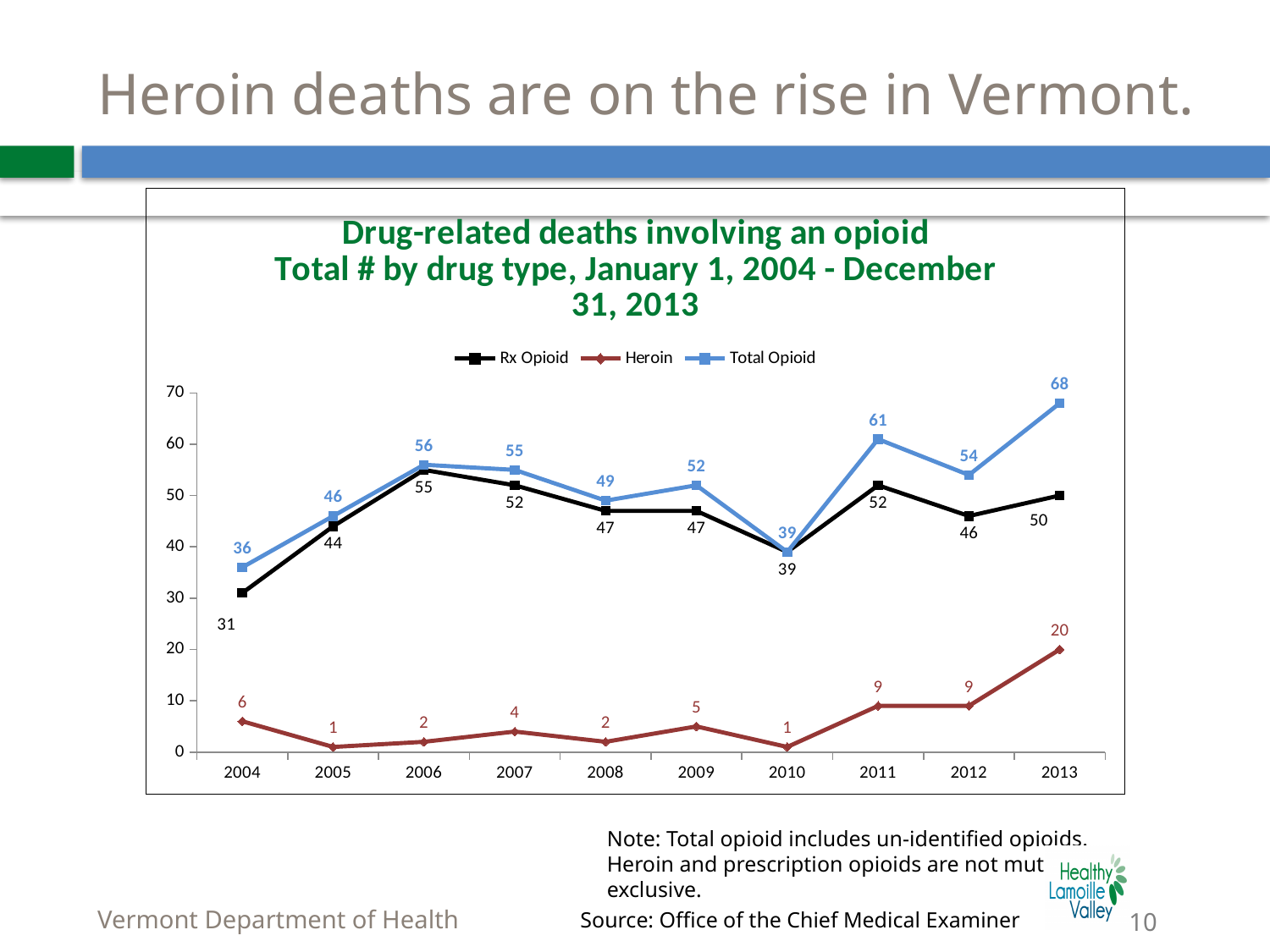
What kind of chart is shown on the slide? line chart Is the Total Opioid value for 2010 greater or less than 40? less How many series does the legend list? 3 How many years are shown on the x axis? 10 Does the Heroin series rise or fall from 2010 to 2013? rise In which year is the Rx Opioid series lowest? 2004 What is the difference between the Total Opioid and Rx Opioid values in 2011? 9 What is the Rx Opioid value for 2004? 31 What is the Heroin value for 2010? 1 What is the Total Opioid value for 2013? 68 In which year is the Total Opioid series highest? 2013 Which is larger, the Heroin value in 2013 or the Heroin value in 2011? 2013